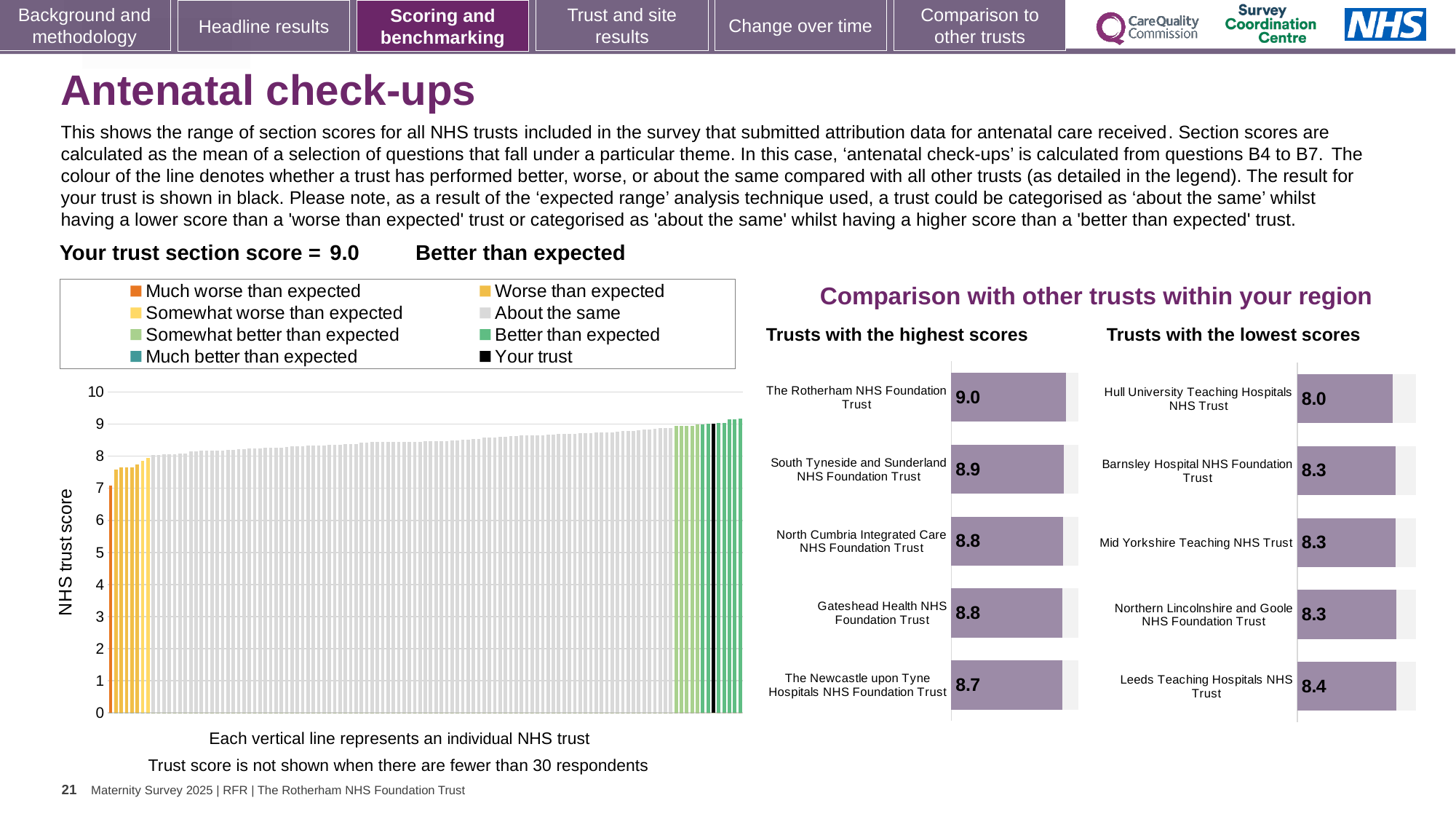
How many entries does the legend of the main NHS trust score chart list? 8 What kind of chart is the main chart on the left showing NHS trust scores? Bar chart In the main NHS trust score chart, do the bar values rise or fall from left to right? Rise How many trusts are shown in the 'Trusts with the lowest scores' chart? 5 What is the difference between the score for The Rotherham NHS Foundation Trust in the highest scores chart and the score for Hull University Teaching Hospitals NHS Trust in the lowest scores chart? 1.0 In the 'Trusts with the lowest scores' chart, what is the score for Hull University Teaching Hospitals NHS Trust? 8.0 In the 'Trusts with the highest scores' chart, which trust has the highest score? The Rotherham NHS Foundation Trust In the 'Trusts with the lowest scores' chart, what is the score for Leeds Teaching Hospitals NHS Trust? 8.4 In the 'Trusts with the highest scores' chart, what is the score for The Rotherham NHS Foundation Trust? 9.0 In the 'Trusts with the highest scores' chart, which has the larger score: South Tyneside and Sunderland NHS Foundation Trust or Gateshead Health NHS Foundation Trust? South Tyneside and Sunderland NHS Foundation Trust In the 'Trusts with the highest scores' chart, what is the score for The Newcastle upon Tyne Hospitals NHS Foundation Trust? 8.7 In the 'Trusts with the lowest scores' chart, which trust has the lowest score? Hull University Teaching Hospitals NHS Trust